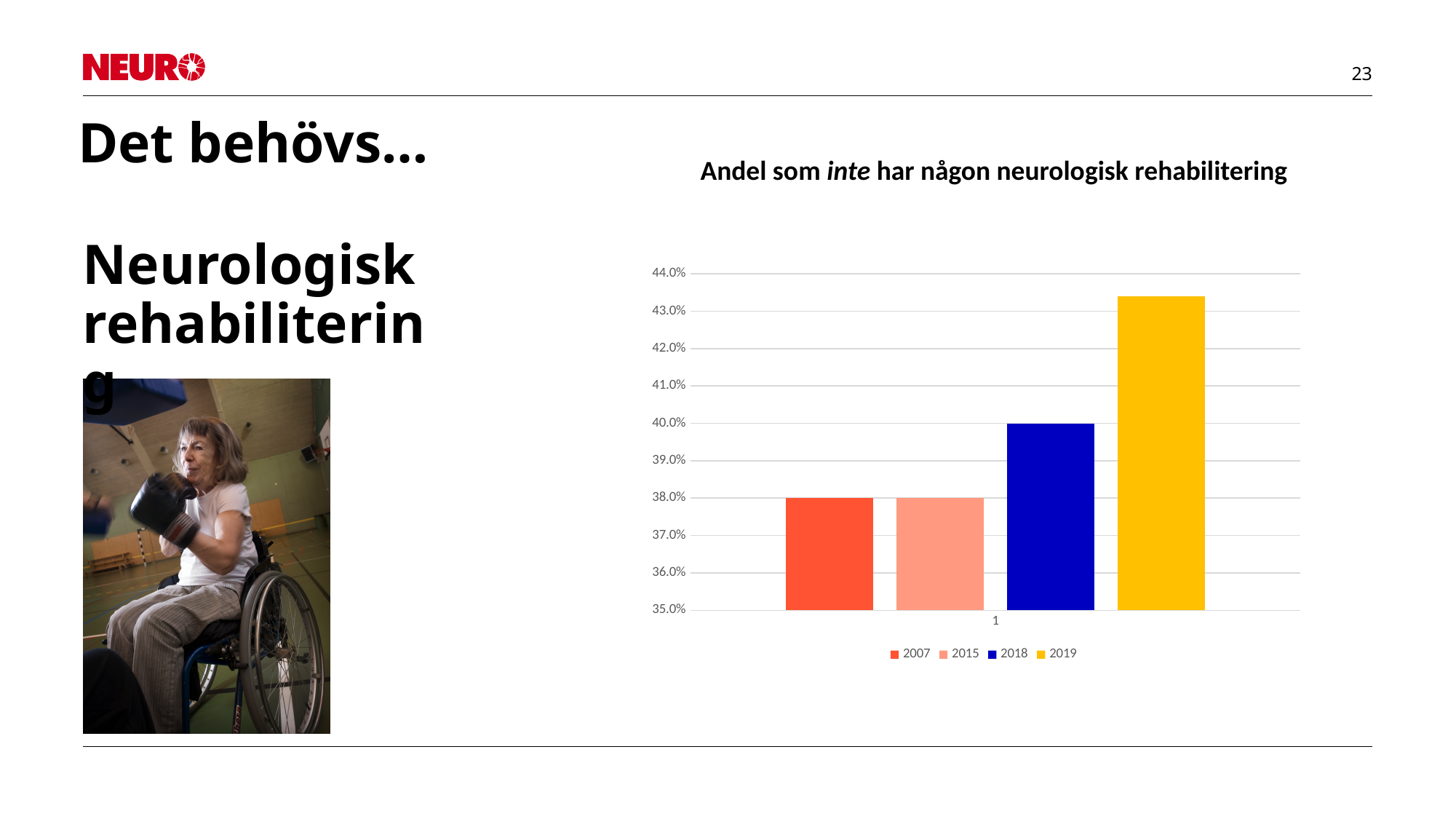
What is the value for 2015? 38.0% What is the value for 2007? 38.0% What is the title of the chart? Andel som inte har någon neurologisk rehabilitering Which is larger, the value for 2018 or the value for 2007? 2018 What is the difference between the values for 2018 and 2007? 2.0% What kind of chart is shown on the slide? bar chart What is the value for 2018? 40.0% Do the values rise or fall from 2007 to 2019? rise Is the value for 2019 greater or less than 43.0%? greater How many series does the chart legend list? 4 Which year has the highest value? 2019 Is the value for 2019 greater or less than 44.0%? less